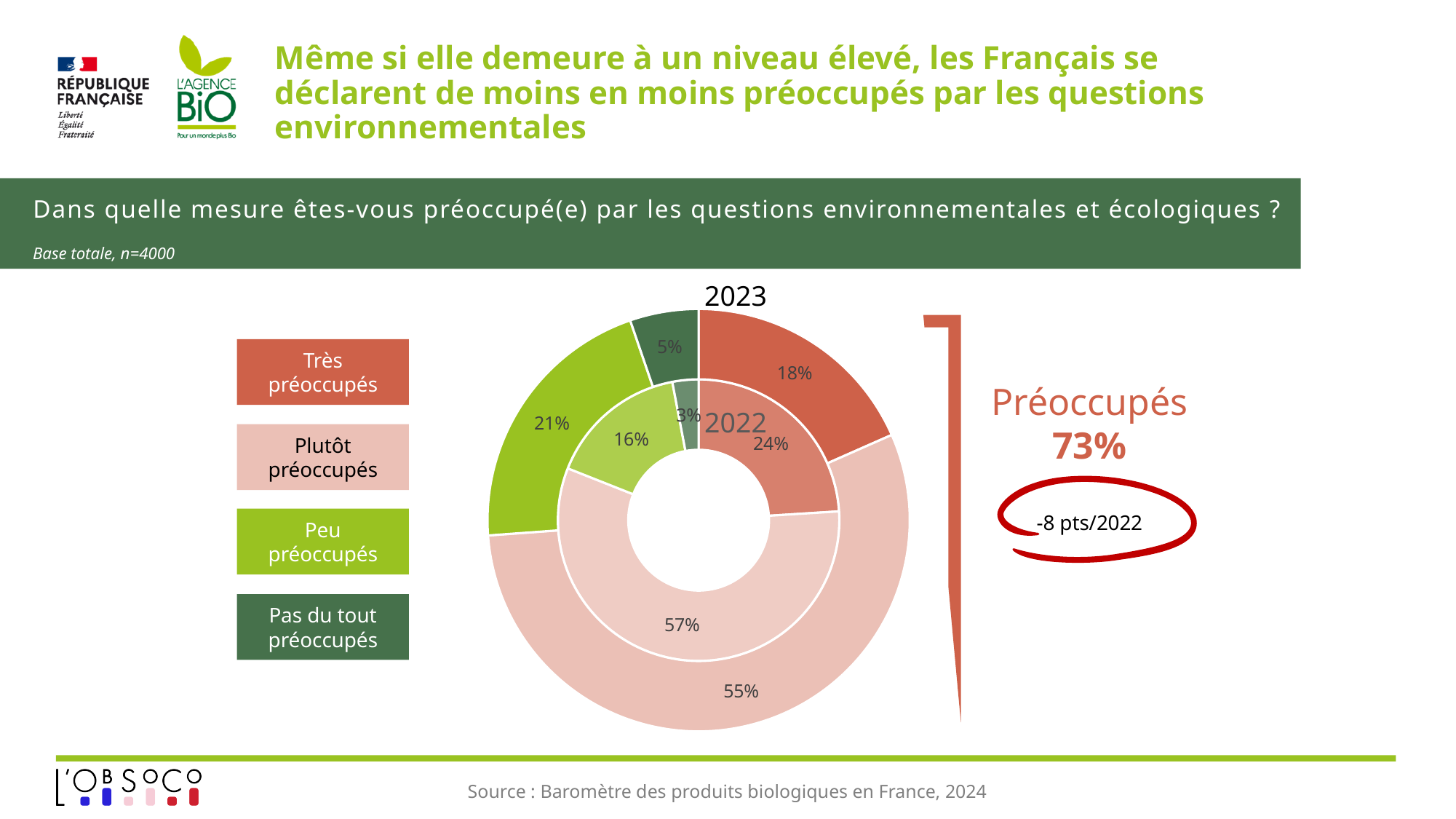
Which category has the smallest share in the 2022 ring? Pas du tout préoccupés What percentage of respondents were 'Peu préoccupés' in 2023? 21% What percentage of respondents were 'Pas du tout préoccupés' in 2022? 3% What type of chart is shown on the slide? Doughnut chart What percentage of respondents were 'Plutôt préoccupés' in 2022? 57% Which is larger: the 'Peu préoccupés' share in 2023 or in 2022? 2023 (21% vs 16%) What is the combined share of 'Très préoccupés' and 'Plutôt préoccupés' in 2023, as shown on the slide? 73% By how many percentage points did 'Très préoccupés' change from 2022 to 2023? 6 points lower (24% to 18%) How many response categories does the legend list? 4 Which category has the largest share in the 2023 ring? Plutôt préoccupés What percentage of respondents were 'Très préoccupés' in 2023? 18% Which year is represented by the inner ring of the doughnut chart? 2022